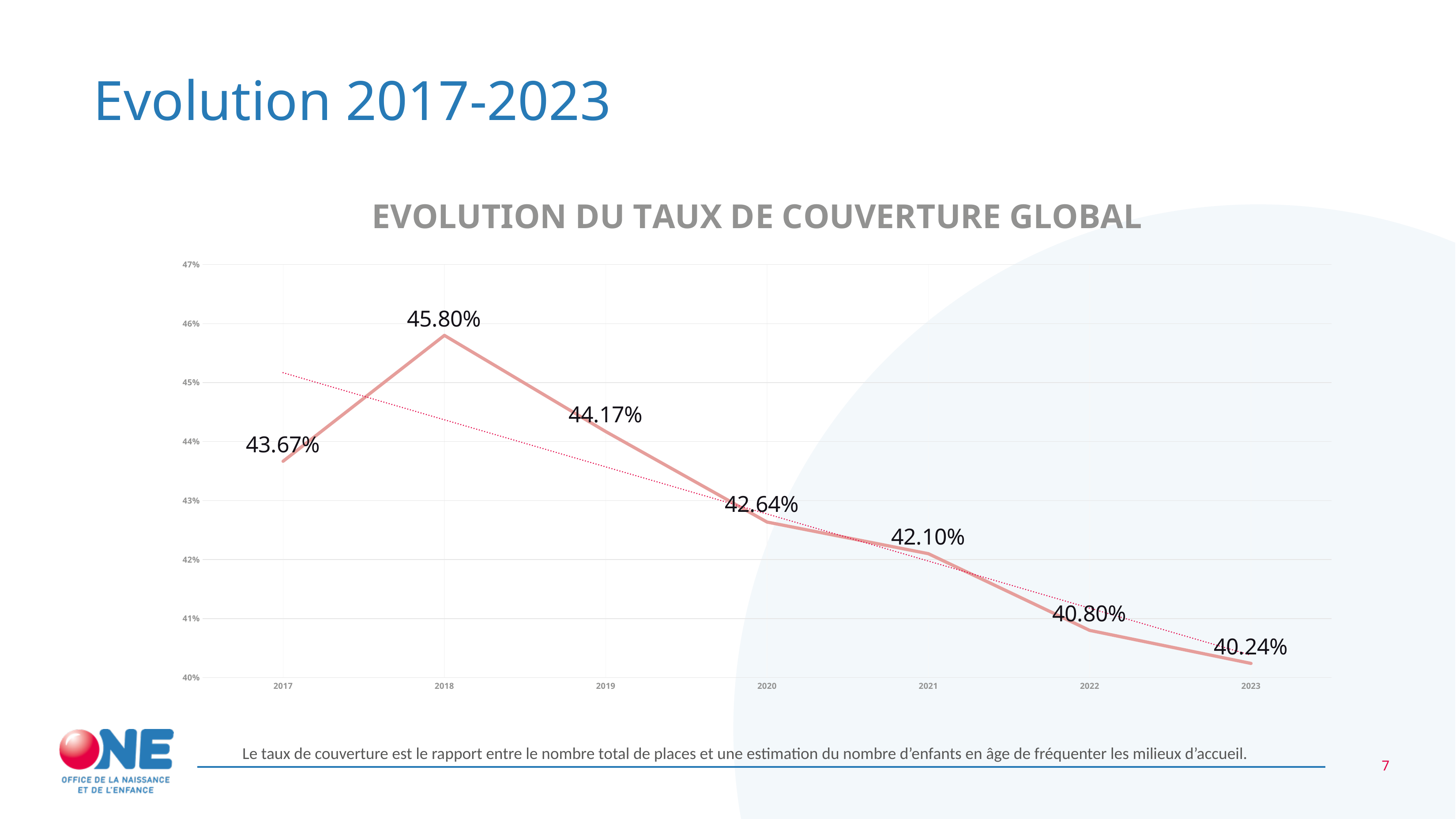
Is the coverage rate for 2022 greater or less than 41%? less How many years are plotted on the x axis? 7 What is the title of the chart? EVOLUTION DU TAUX DE COUVERTURE GLOBAL Which year has the highest coverage rate? 2018 What is the difference between the coverage rate in 2018 and in 2023? 5.56% Which year has the lowest coverage rate? 2023 What is the coverage rate shown for 2020? 42.64% Which is larger, the coverage rate in 2019 or in 2021? 2019 What is the coverage rate shown for 2018? 45.80% What is the difference between the coverage rate in 2017 and in 2018? 2.13% What is the coverage rate shown for 2023? 40.24% What kind of chart is shown on the slide? line chart